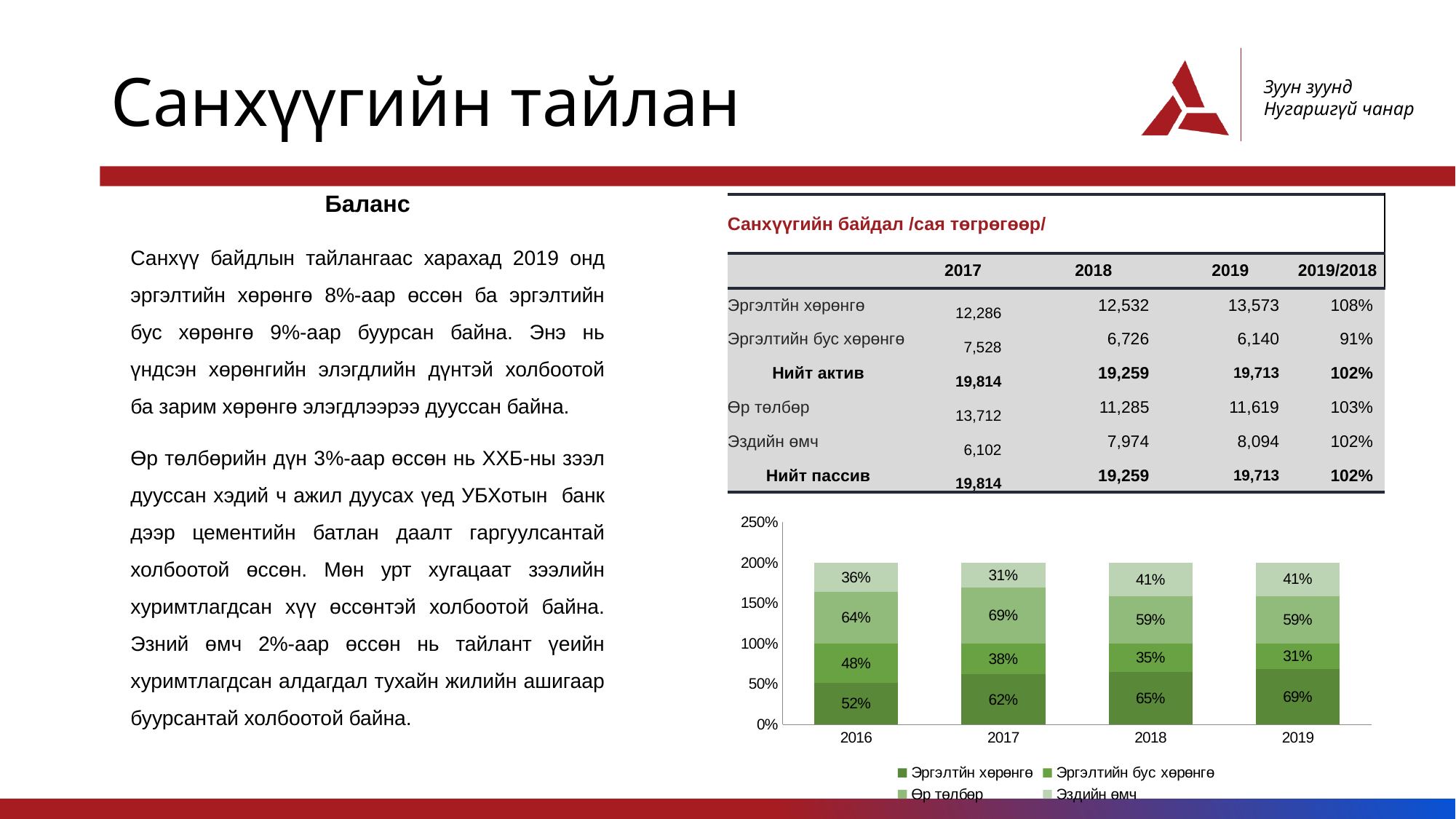
In which year is the Эздийн өмч (top) segment the lowest in the chart? 2017 In which year is the Эргэлтийн хөрөнгө (bottom) segment the highest in the chart? 2019 How many series does the chart legend list? 4 Which is larger in the chart: the Өр төлбөр segment in 2016 or in 2018? 2016 What is the value of the top segment (Эздийн өмч) for 2016 in the chart? 36% What is the value of the Өр төлбөр segment for 2017 in the chart? 69% What is the value of the Эргэлтийн бус хөрөнгө segment for 2018 in the chart? 35% How many years are shown on the x axis of the chart? 4 What is the value of the bottom segment (Эргэлтийн хөрөнгө) for 2019 in the chart? 69% What kind of chart is shown on the slide? Stacked bar chart Does the Эргэлтийн хөрөнгө (bottom) segment rise or fall from 2016 to 2019 in the chart? Rise What is the difference between the Эргэлтийн хөрөнгө segment in 2019 and in 2016 in the chart? 17%